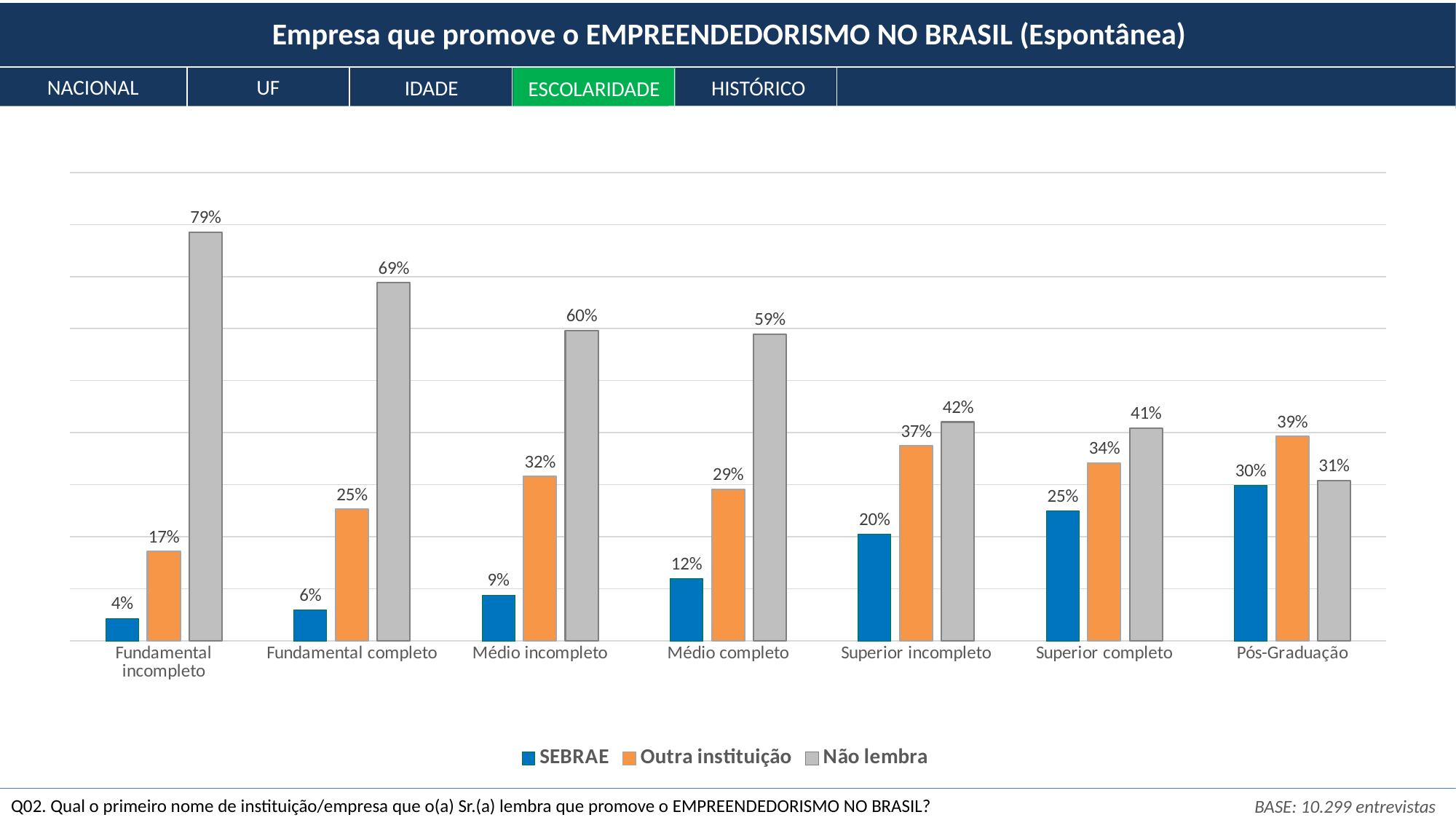
What is the SEBRAE value for Médio completo? 12% Does the SEBRAE value rise or fall from Fundamental incompleto to Pós-Graduação? Rise What is the difference between the Não lembra values for Fundamental incompleto and Fundamental completo? 10% What kind of chart is shown on the slide? Bar chart What is the Outra instituição value for Superior completo? 34% Which tab is highlighted in green at the top of the slide? ESCOLARIDADE Which education level has the highest SEBRAE value? Pós-Graduação How many series does the legend list? 3 What is the Não lembra value for Fundamental incompleto? 79% Which is larger for Pós-Graduação: the SEBRAE value or the Outra instituição value? Outra instituição How many education levels are shown on the x axis? 7 Which education level has the lowest Não lembra value? Pós-Graduação